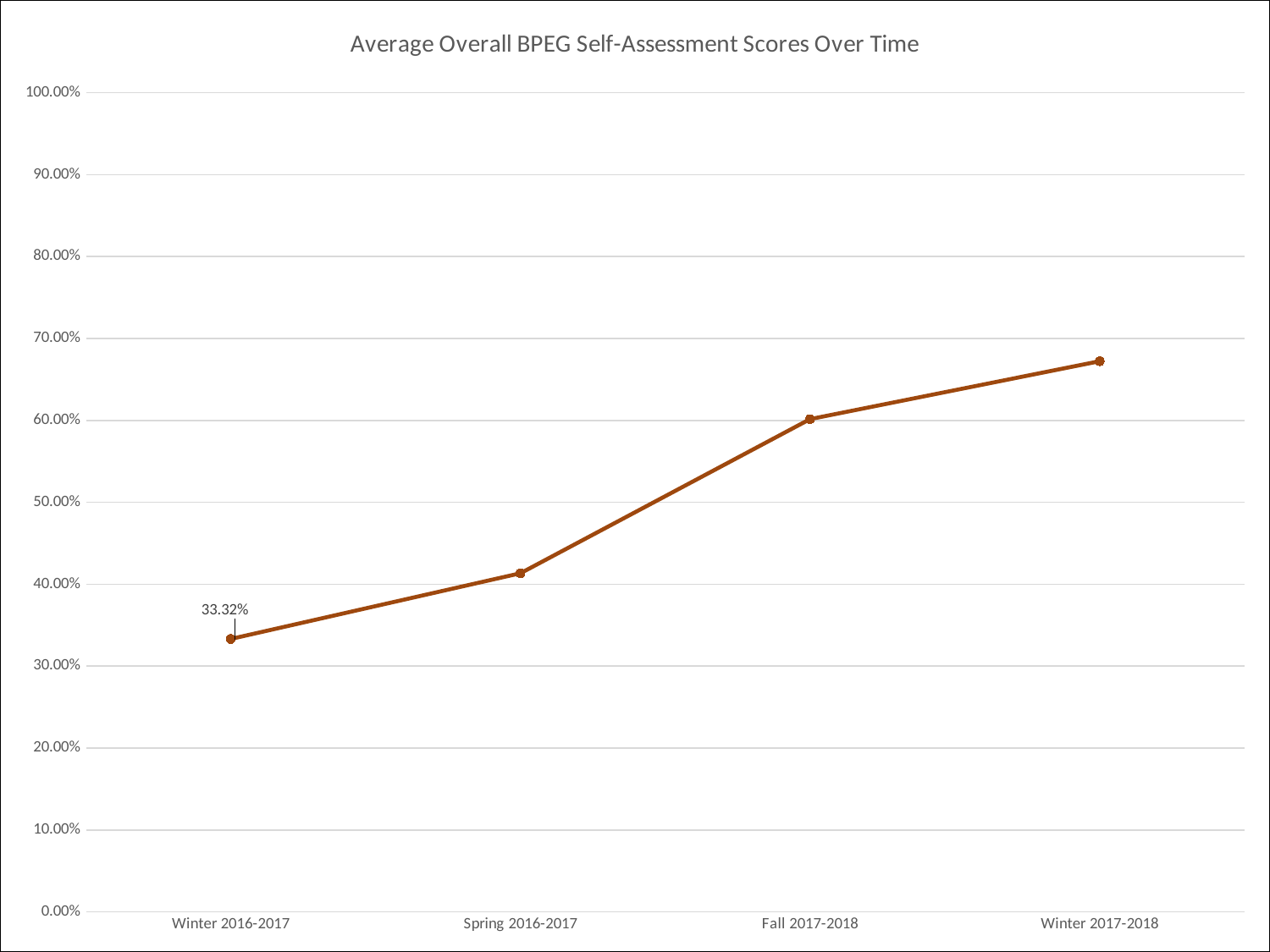
Is the value for Winter 2016-2017 greater or less than 30.00%? greater Which period has the lowest score? Winter 2016-2017 Do the scores rise or fall from Winter 2016-2017 to Winter 2017-2018? rise What is the value for Winter 2016-2017? 33.32% How many data points are plotted on the line? 4 Is the value for Winter 2017-2018 greater or less than 60.00%? greater Which is larger, the value for Fall 2017-2018 or the value for Spring 2016-2017? Fall 2017-2018 Which period has the highest score? Winter 2017-2018 Is the value for Fall 2017-2018 greater or less than 70.00%? less What is the title of the chart? Average Overall BPEG Self-Assessment Scores Over Time What kind of chart is shown on the slide? line chart